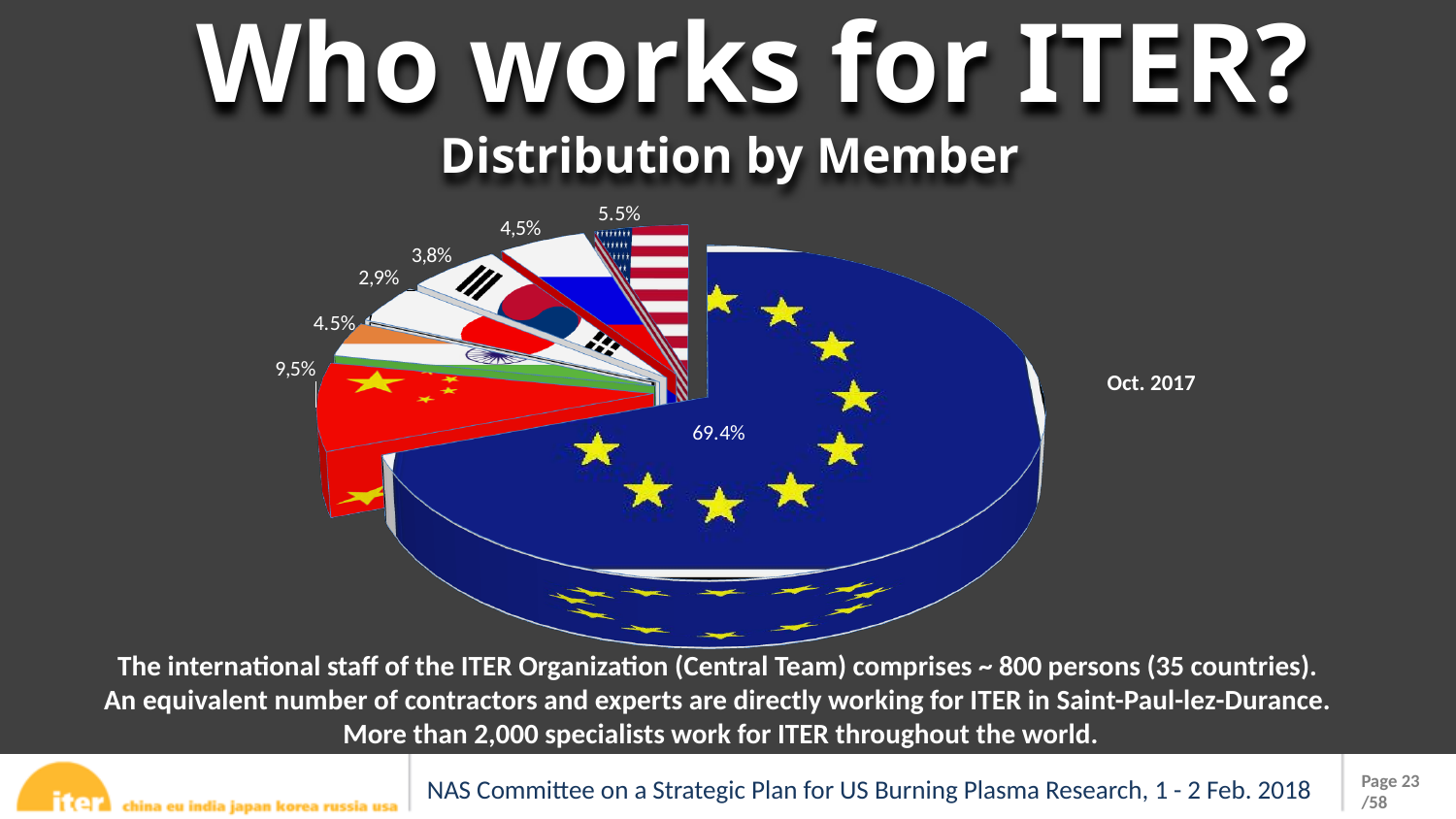
What date is noted next to the pie chart? Oct. 2017 What is the title of the chart on the slide? Distribution by Member Which slice is larger, the one with the Chinese flag or the one with the United States flag? the Chinese flag slice What is the smallest percentage shown on the pie chart? 2,9% What is the difference in percentage points between the largest slice (69.4%) and the slice labelled 9,5%? 59.9 percentage points What percentage is shown for the slice with the Chinese flag? 9,5% What percentage is shown for the slice with the European Union flag? 69.4% How many slices does the pie chart have? 7 What percentage is shown for the slice with the United States flag? 5.5% Is the share of the slice with the European Union flag greater or less than 50%? greater What kind of chart is shown on the slide? pie chart What is the largest percentage shown on the pie chart? 69.4%